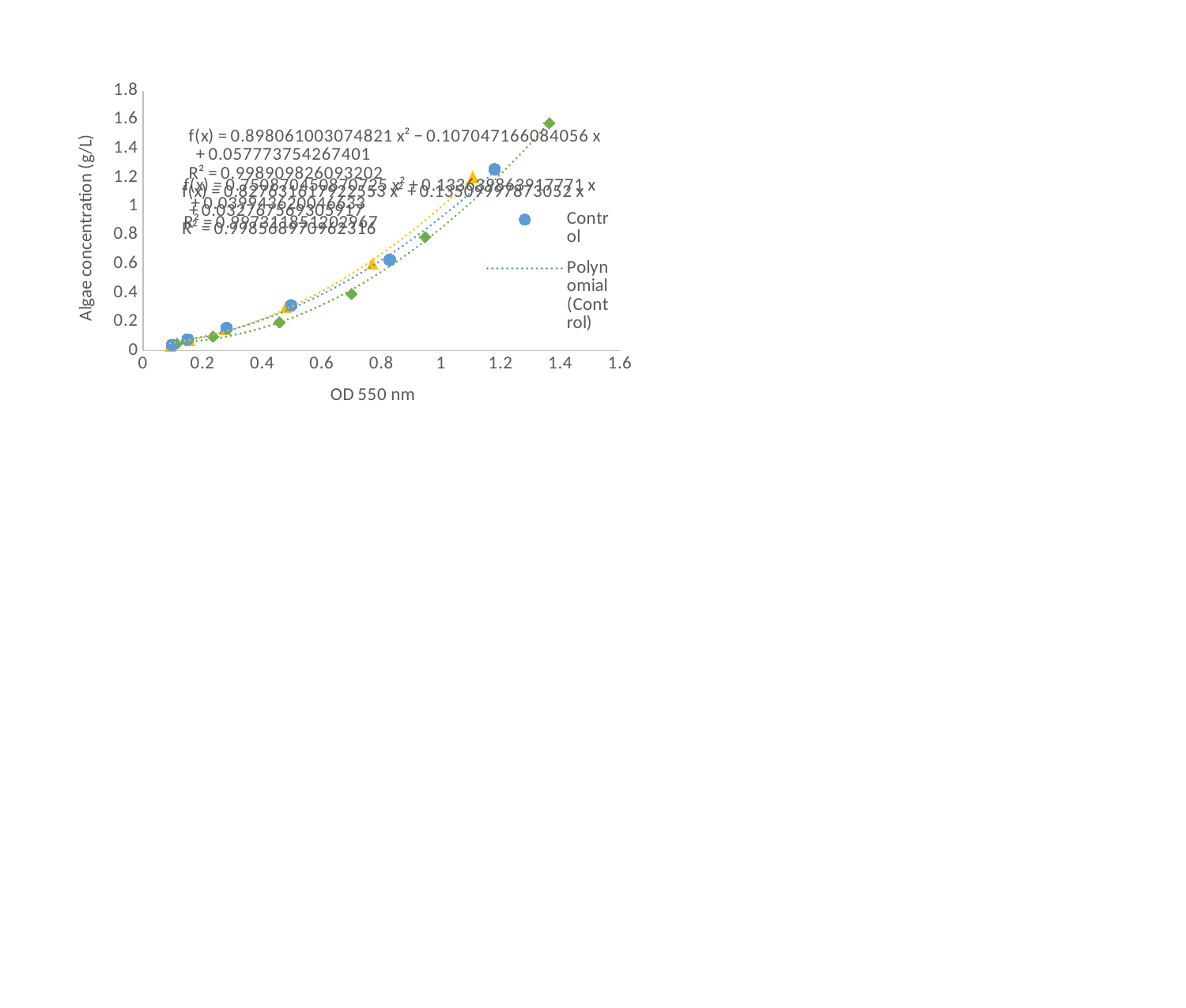
Do the Control values rise or fall as OD 550 nm increases? rise Is the Control value at OD 550 nm of about 0.8 greater or less than 0.8? less Which series is named in the legend as the plotted data series? Control What is the title of the y axis? Algae concentration (g/L) Is the Control value at OD 550 nm of about 0.5 greater or less than 0.4? less What is the highest tick value shown on the y axis? 1.8 What kind of chart is shown on the slide? scatter chart What is the R² value shown for the first (topmost) trendline equation? 0.998909826093202 What is the highest tick value shown on the x axis? 1.6 Is the Control value at the highest OD 550 nm reading (around 1.2) greater or less than 1? greater What is the title of the x axis? OD 550 nm